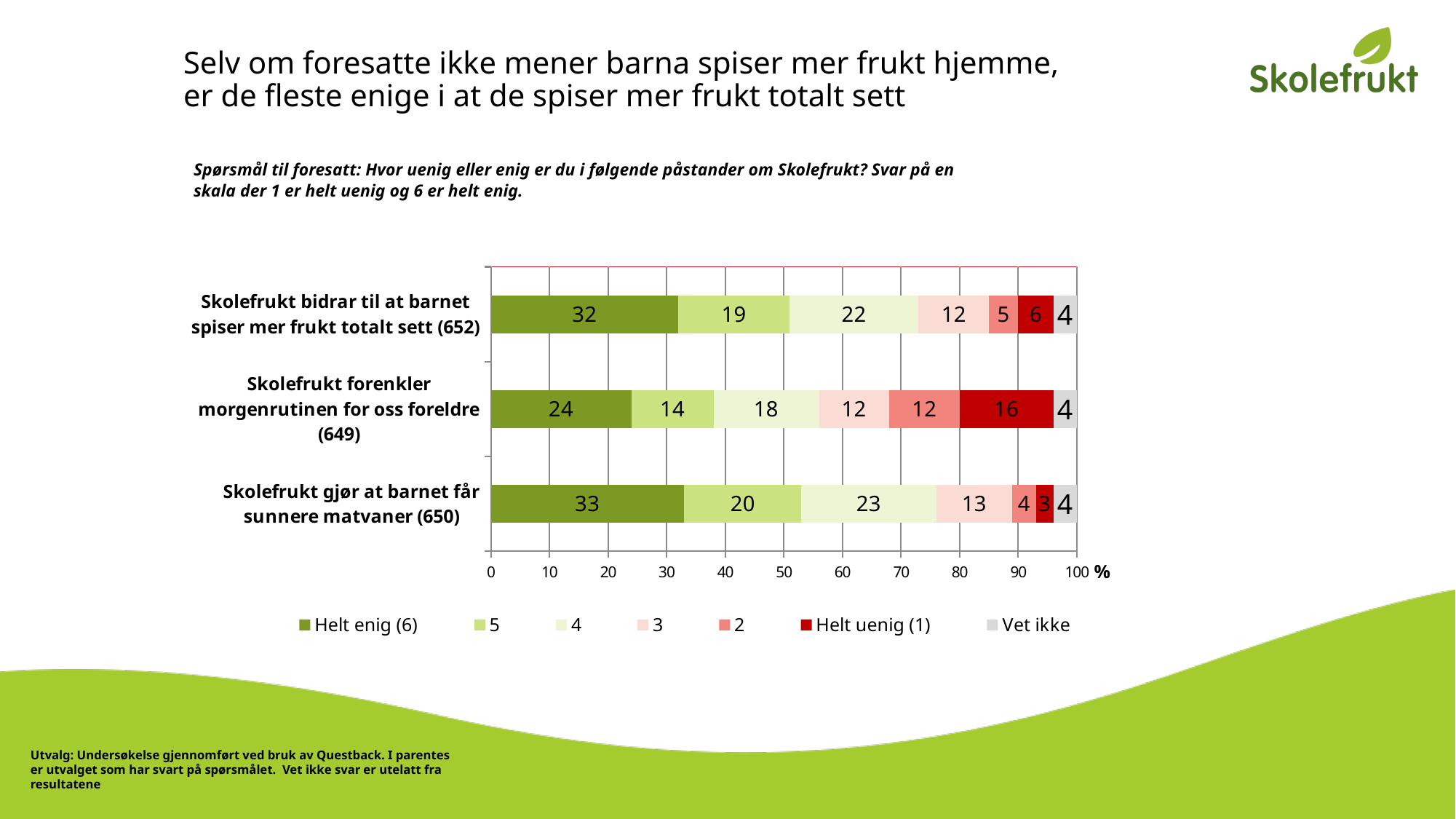
What is the 'Helt enig (6)' value for 'Skolefrukt forenkler morgenrutinen for oss foreldre (649)'? 24 How many series does the legend list? 7 What is the 'Vet ikke' value for 'Skolefrukt gjør at barnet får sunnere matvaner (650)'? 4 What is the total of the stacked bar for 'Skolefrukt forenkler morgenrutinen for oss foreldre (649)'? 100 What is the 'Helt uenig (1)' value for 'Skolefrukt bidrar til at barnet spiser mer frukt totalt sett (652)'? 6 What is the difference between the 'Helt uenig (1)' values for 'Skolefrukt forenkler morgenrutinen for oss foreldre (649)' and 'Skolefrukt bidrar til at barnet spiser mer frukt totalt sett (652)'? 10 Which is larger: the '5' value for 'Skolefrukt bidrar til at barnet spiser mer frukt totalt sett (652)' or for 'Skolefrukt forenkler morgenrutinen for oss foreldre (649)'? Skolefrukt bidrar til at barnet spiser mer frukt totalt sett (652) What is the value for '4' for 'Skolefrukt gjør at barnet får sunnere matvaner (650)'? 23 How many statements (categories) are plotted in the chart? 3 Which statement has the lowest 'Helt uenig (1)' value? Skolefrukt gjør at barnet får sunnere matvaner (650) What kind of chart is shown on the slide? Stacked bar chart Which statement has the highest 'Helt enig (6)' value? Skolefrukt gjør at barnet får sunnere matvaner (650)